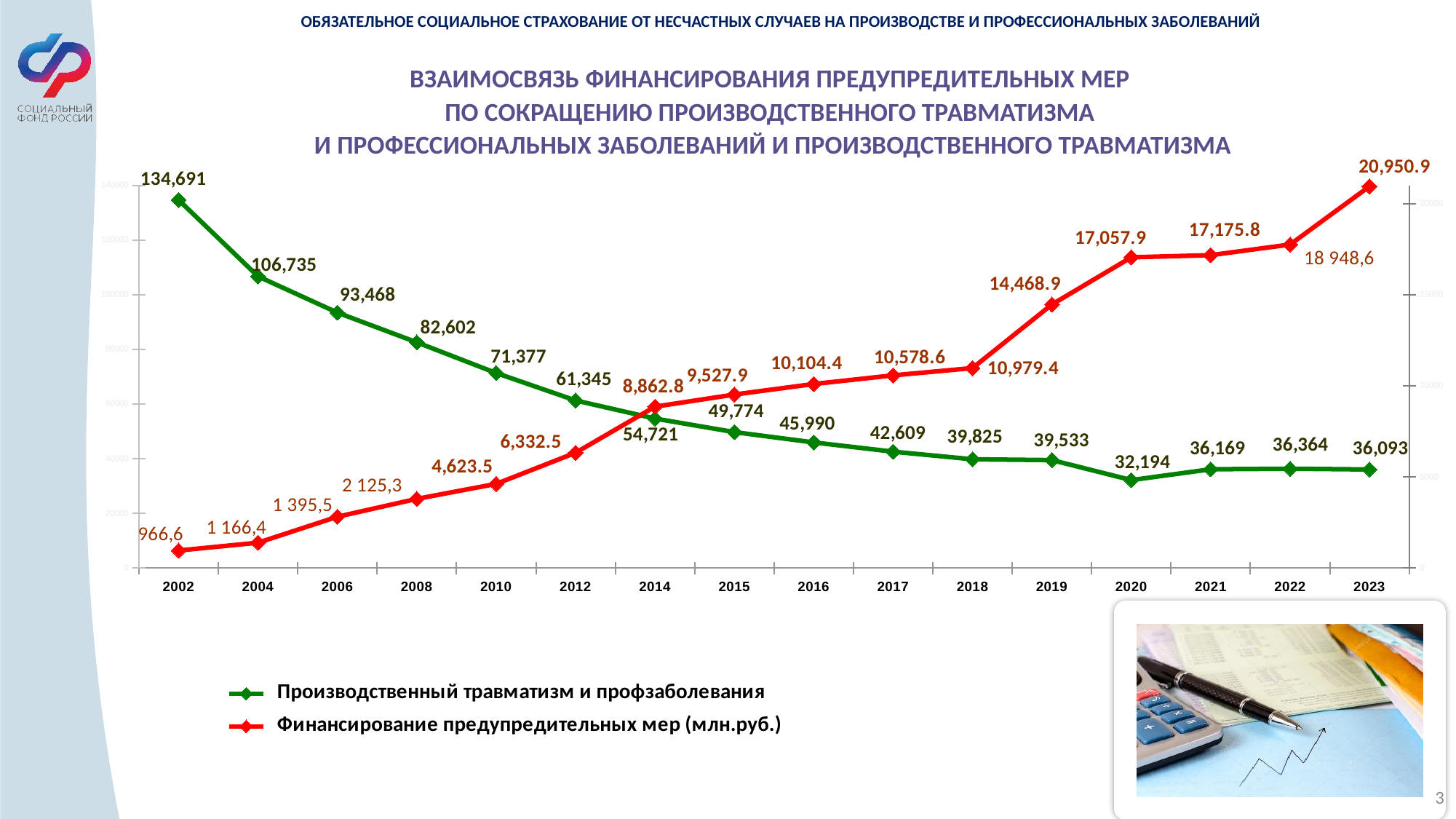
What is the value of Финансирование предупредительных мер (млн.руб.) in 2019? 14,468.9 What is the value of Производственный травматизм и профзаболевания in 2002? 134,691 What is the value of Производственный травматизм и профзаболевания in 2016? 45,990 Does Производственный травматизм и профзаболевания rise or fall from 2002 to 2012? fall By how much did Производственный травматизм и профзаболевания decrease from 2002 to 2023? 98,598 What type of chart is shown on the slide? line chart In which year is Производственный травматизм и профзаболевания lowest? 2020 How many years are plotted along the x axis? 16 Which series has the larger value in 2014, Производственный травматизм и профзаболевания or Финансирование предупредительных мер (млн.руб.)? Производственный травматизм и профзаболевания In which year is Финансирование предупредительных мер (млн.руб.) highest? 2023 How many series does the legend list? 2 What is the value of Финансирование предупредительных мер (млн.руб.) in 2023? 20,950.9